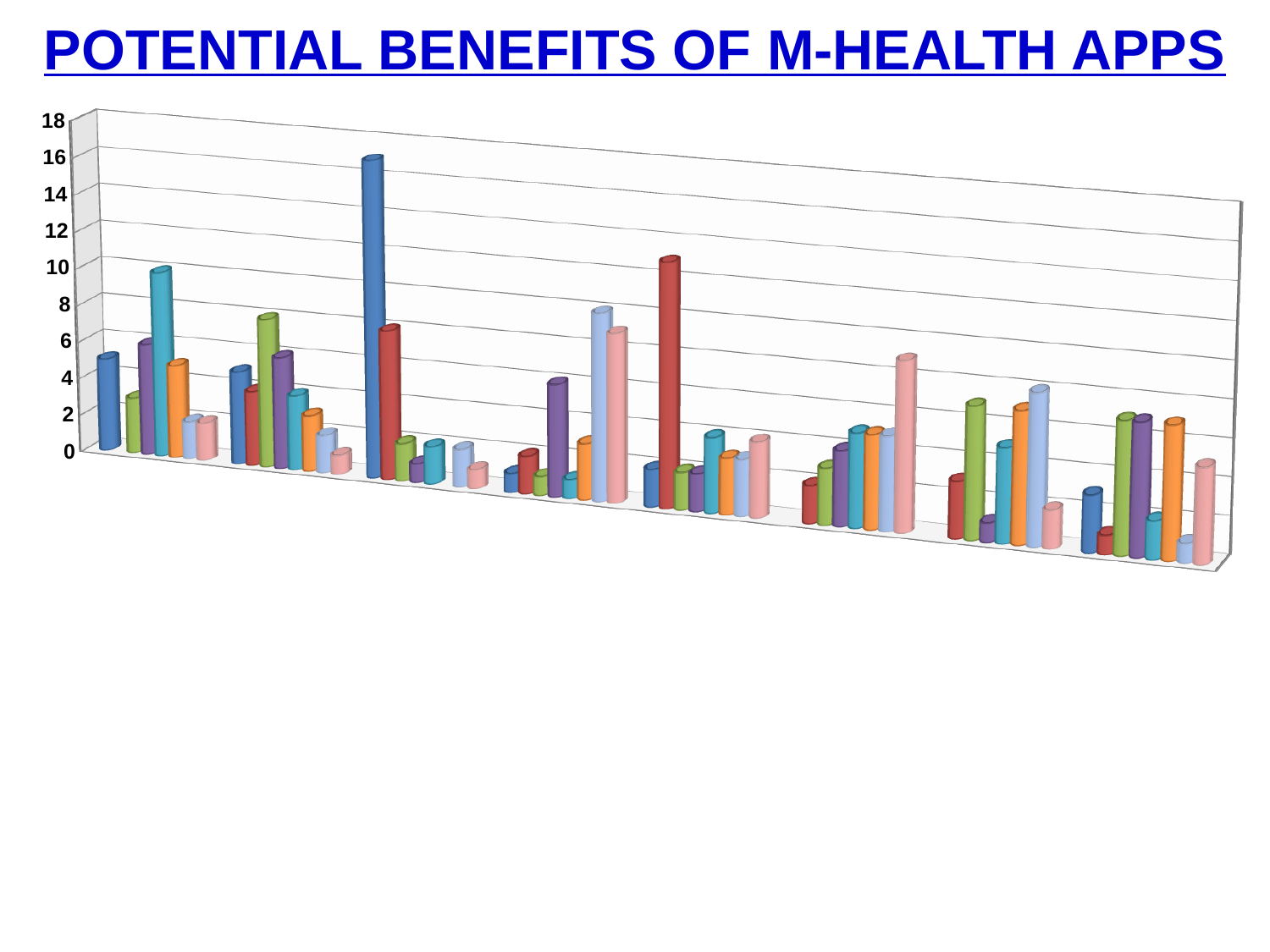
What is the highest value shown on the vertical axis of the chart? 18 What kind of chart is shown on the slide? bar chart What is the title of the chart on the slide? POTENTIAL BENEFITS OF M-HEALTH APPS Is the value of the tallest bar in the chart greater or less than 18? less Is the value of the tallest bar in the chart greater or less than 14? greater How many groups of bars are plotted along the horizontal axis of the chart? 8